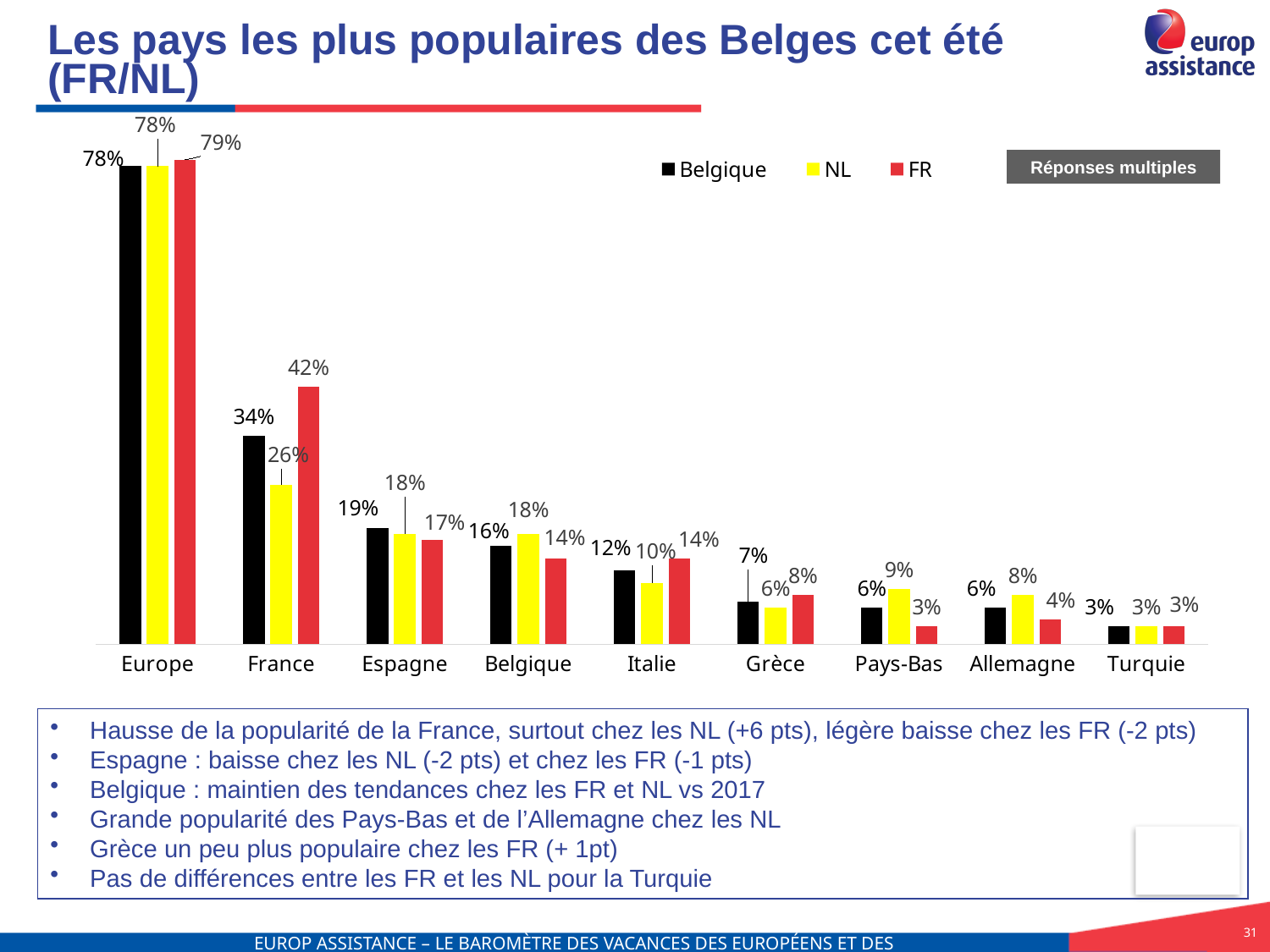
How many countries are shown on the x axis? 9 What is the FR value for France? 42% What kind of chart is shown on the slide? Bar chart What is the difference between the FR and NL values for France? 16% How many series does the legend list? 3 Which colour represents the NL series in the legend? Yellow Which country has the lowest Belgique value? Turquie What is the NL value for Pays-Bas? 9% What is the FR value for Europe? 79% What is the Belgique value for Espagne? 19% For Pays-Bas, which is larger: the NL value or the FR value? NL Which country has the highest FR value? Europe